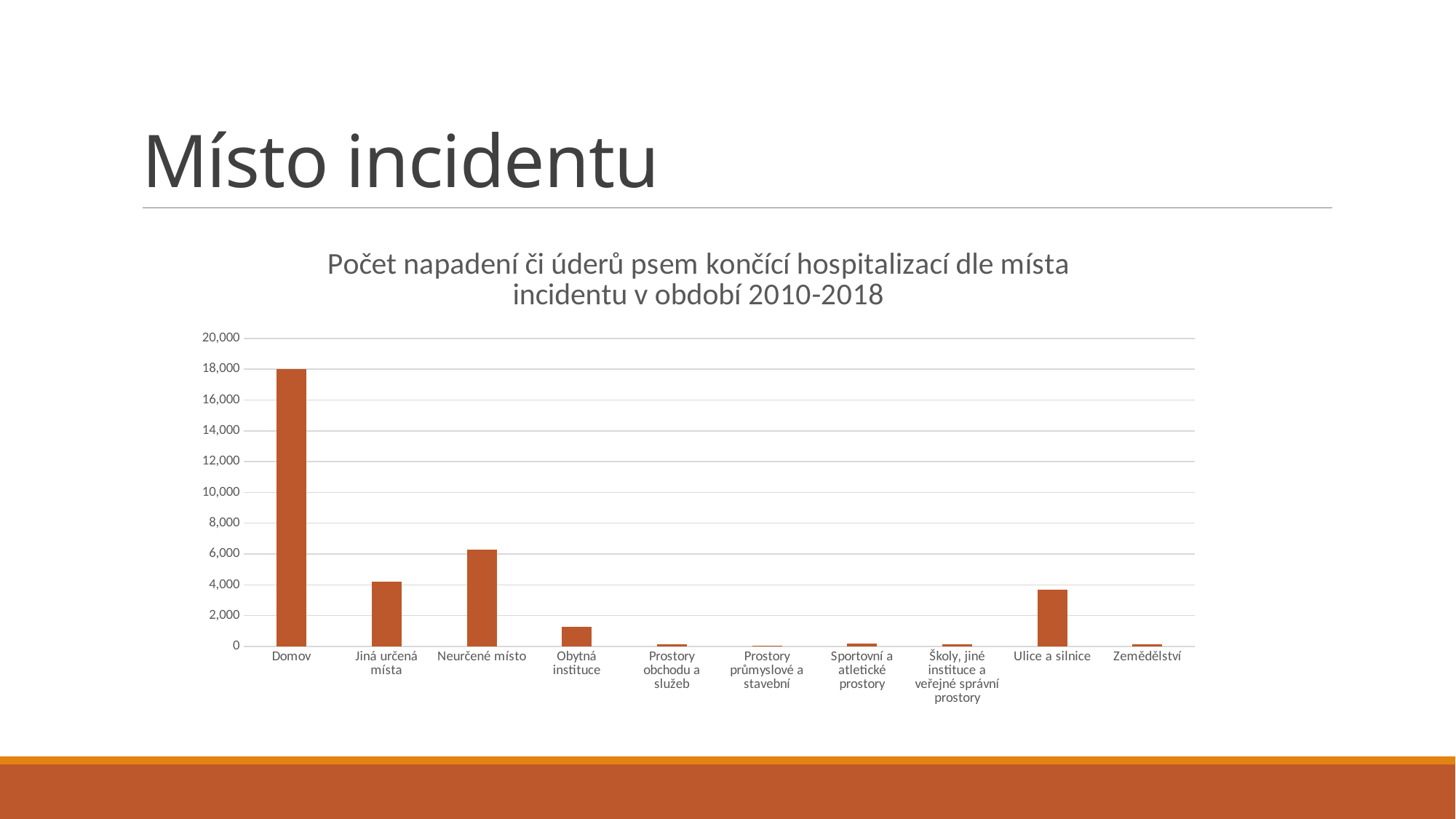
Is the value for Neurčené místo greater or less than 8,000? less Which has a larger value, Ulice a silnice or Obytná instituce? Ulice a silnice What is the highest value shown on the chart's vertical axis? 20,000 Is the value for Jiná určená místa greater or less than 6,000? less Which place of incident has the highest number of hospitalisations in the chart? Domov Is the value for Domov greater or less than 16,000? greater What is the title of the chart? Počet napadení či úderů psem končící hospitalizací dle místa incidentu v období 2010-2018 How many categories (places of incident) are shown on the x axis of the chart? 10 Which has a larger value, Neurčené místo or Jiná určená místa? Neurčené místo What kind of chart is shown on the slide? bar chart